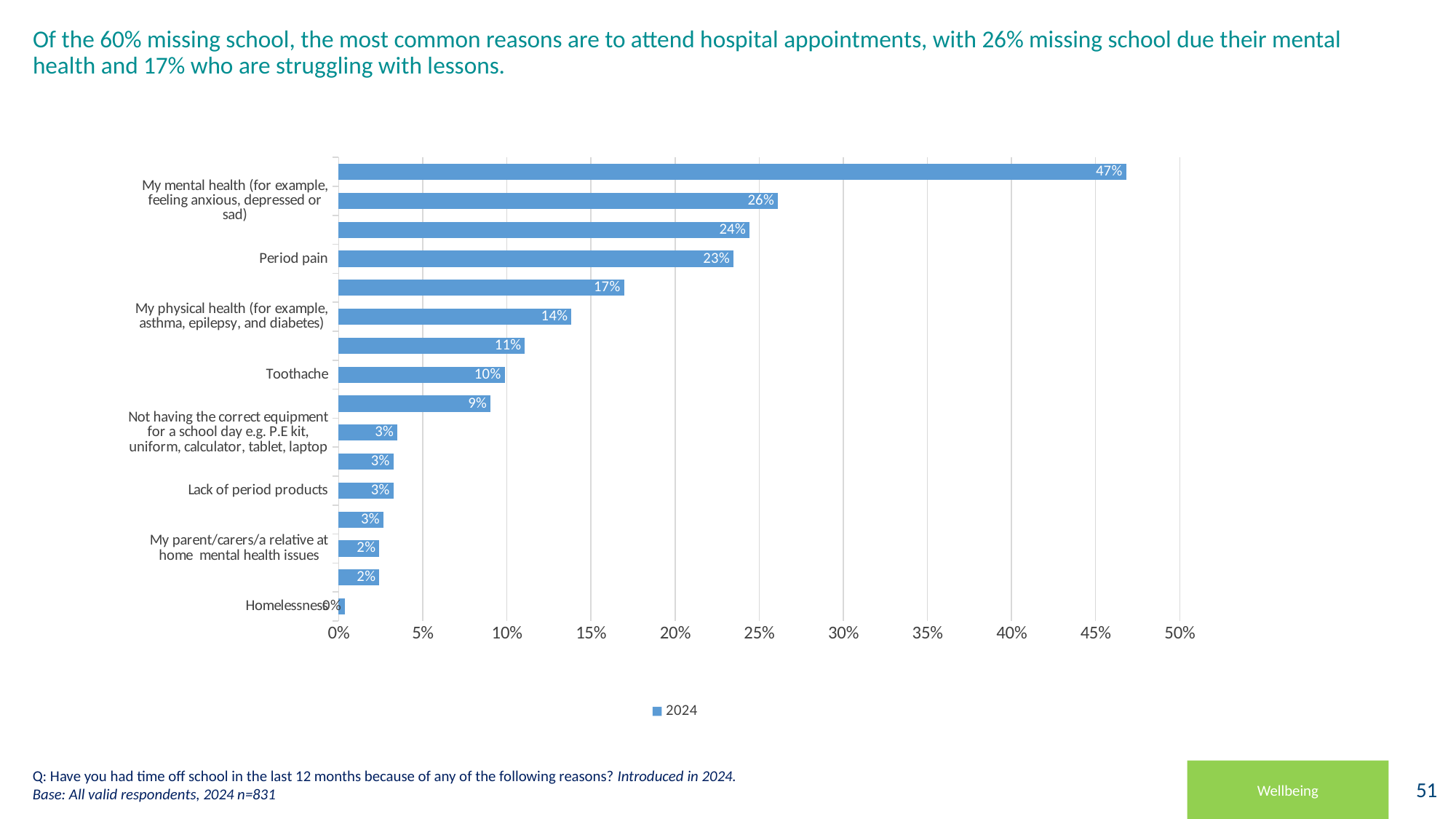
What is the value for Toothache? 10% What kind of chart is shown on the slide? Bar chart What is the highest value shown on the chart? 47% What is the difference between the values for Period pain and Toothache? 13% Which is larger, the value for Period pain or the value for My physical health? Period pain What is the value for My physical health (for example, asthma, epilepsy, and diabetes)? 14% What is the legend entry shown below the chart? 2024 What is the value for Lack of period products? 3% What is the value for My mental health (for example, feeling anxious, depressed or sad)? 26% What is the value for Homelessness? 0% How many series does the legend list? 1 What is the value for Period pain? 23%